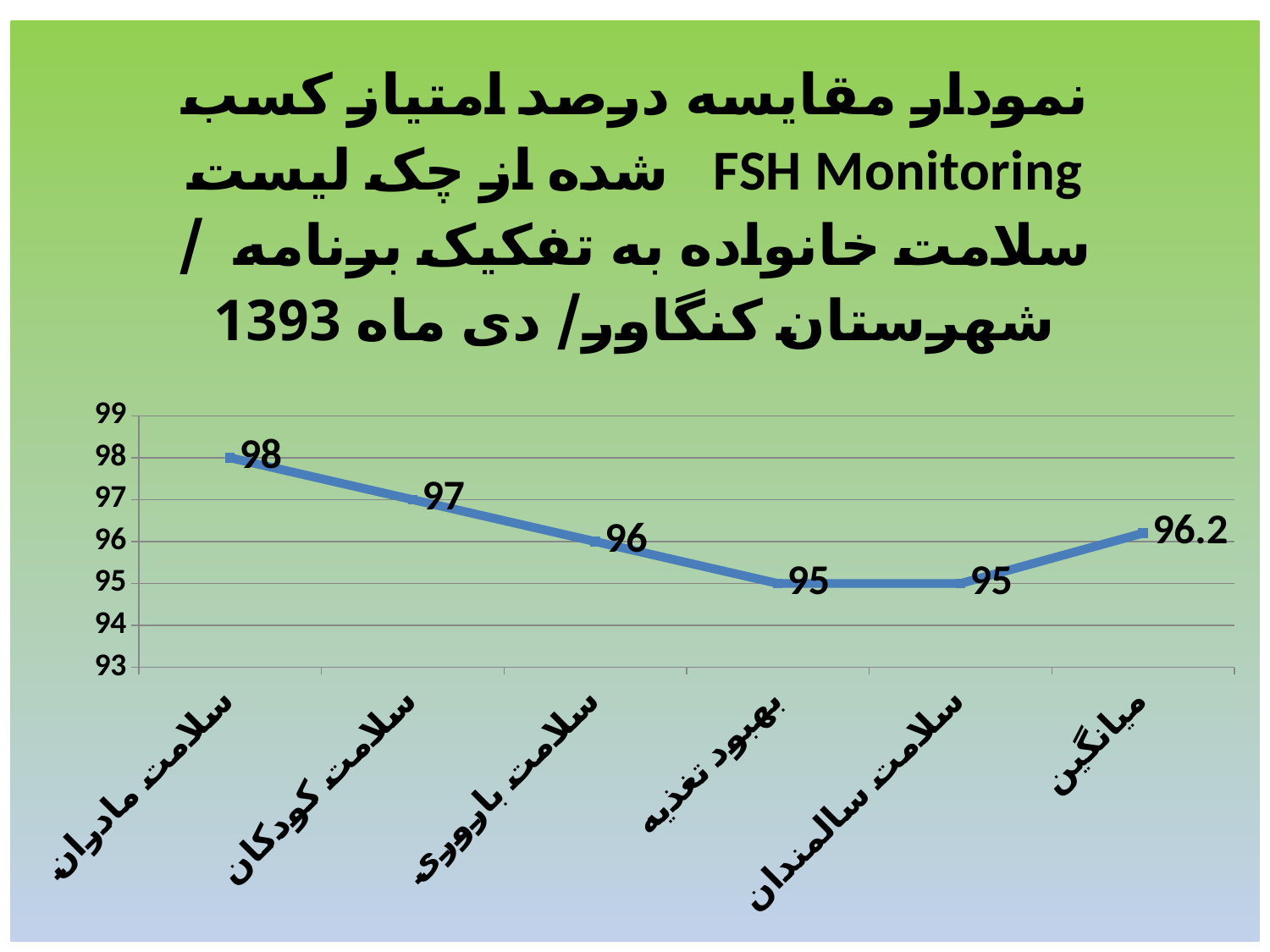
What is the value for سلامت باروری? 96 What is the value for سلامت مادران? 98 How many categories are shown on the x axis? 6 Do the values rise or fall from سلامت مادران to بهبود تغذیه? fall Which category has the highest value? سلامت مادران What is the difference between the values for سلامت مادران and بهبود تغذیه? 3 What is the value for سلامت کودکان? 97 What kind of chart is shown on the slide? line chart What is the value for میانگین? 96.2 What is the lowest value shown on the vertical axis? 93 Is the value for میانگین greater or less than 96? greater Which is larger, the value for سلامت کودکان or the value for سلامت سالمندان? سلامت کودکان